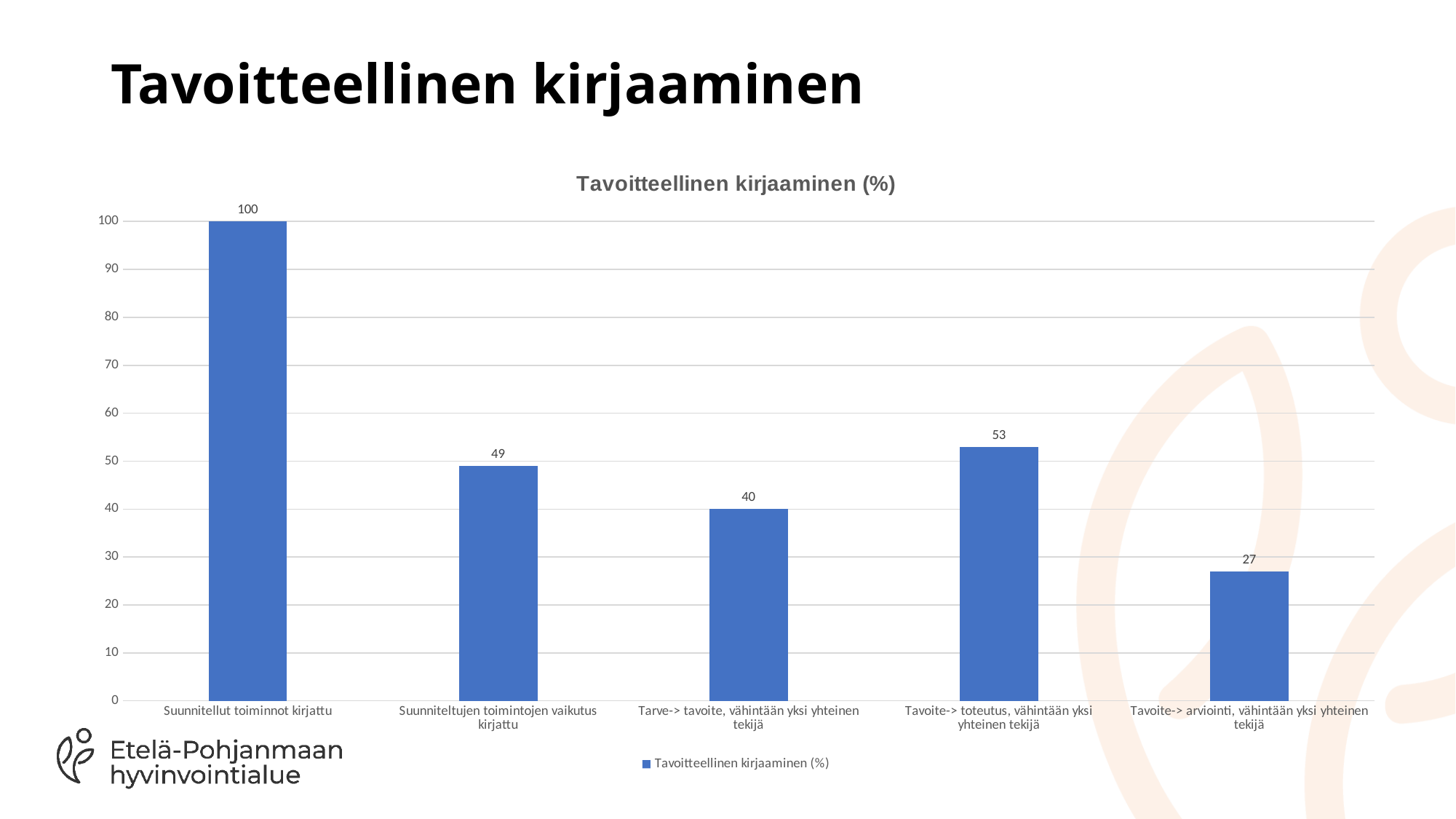
How many series does the legend list? 1 What is the value for "Tavoite-> arviointi, vähintään yksi yhteinen tekijä"? 27 What kind of chart is shown on the slide? bar chart Is the value for "Tarve-> tavoite, vähintään yksi yhteinen tekijä" greater or less than 50? less Which category has the lowest value? Tavoite-> arviointi, vähintään yksi yhteinen tekijä What is the title of the chart? Tavoitteellinen kirjaaminen (%) What is the difference between the values for "Tavoite-> toteutus, vähintään yksi yhteinen tekijä" and "Tarve-> tavoite, vähintään yksi yhteinen tekijä"? 13 Which is larger: the value for "Suunniteltujen toimintojen vaikutus kirjattu" or "Tavoite-> toteutus, vähintään yksi yhteinen tekijä"? Tavoite-> toteutus, vähintään yksi yhteinen tekijä What is the value for "Suunnitellut toiminnot kirjattu"? 100 How many categories are shown in the chart? 5 Which category has the highest value? Suunnitellut toiminnot kirjattu What is the value for "Suunniteltujen toimintojen vaikutus kirjattu"? 49